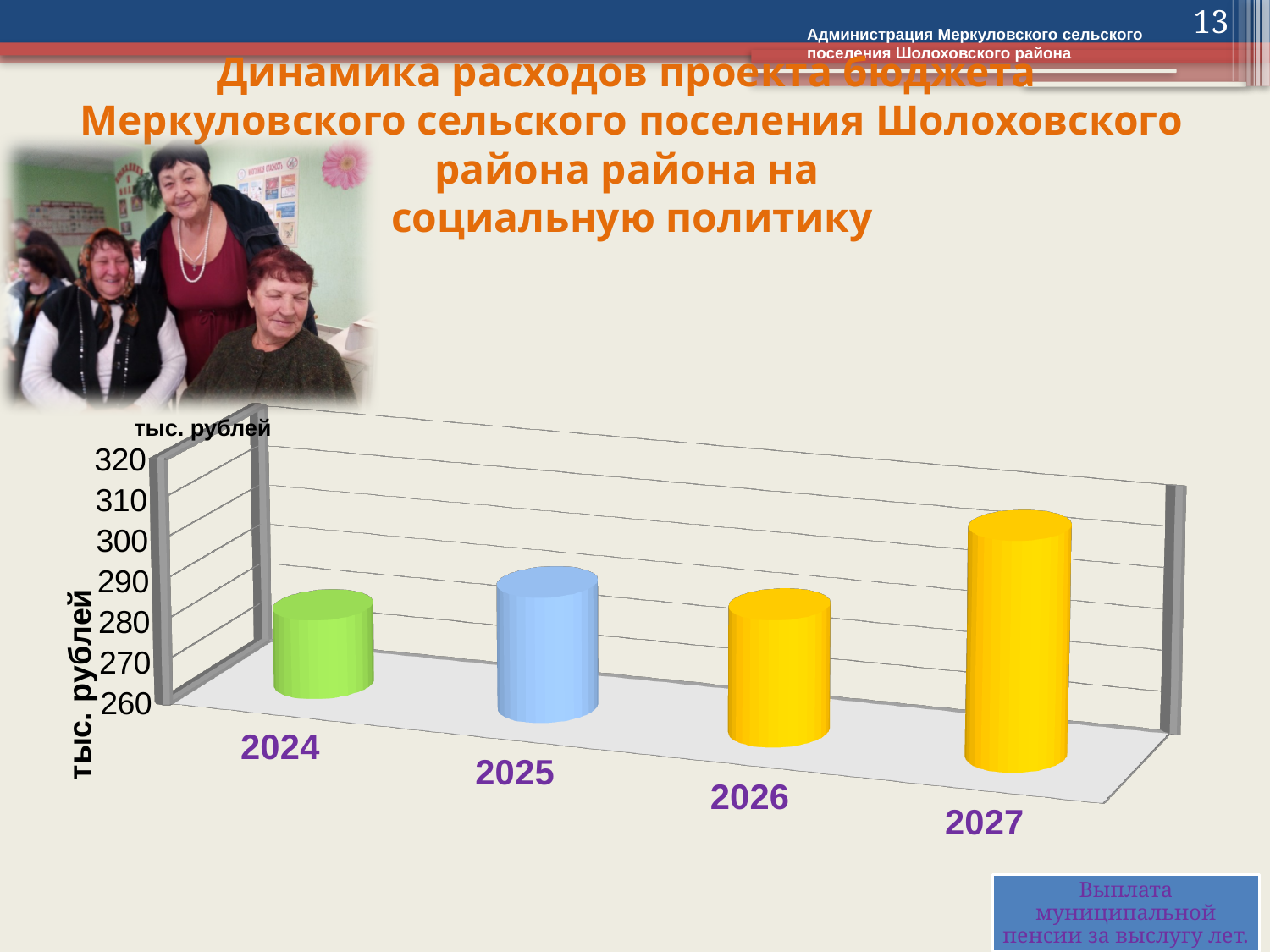
Is the value for 2024 greater or less than 290? less Which is larger, the value for 2025 or the value for 2024? 2025 What is the lowest tick value shown on the vertical axis? 260 What kind of chart is shown on the slide? bar chart How many years are shown on the x axis of the chart? 4 Which year has the lowest value in the chart? 2024 Which is larger, the value for 2027 or the value for 2024? 2027 Is the value for 2027 greater or less than 300? greater Which year has the highest value in the chart? 2027 Is the value for 2026 greater or less than 310? less What unit is shown on the vertical axis of the chart? тыс. рублей